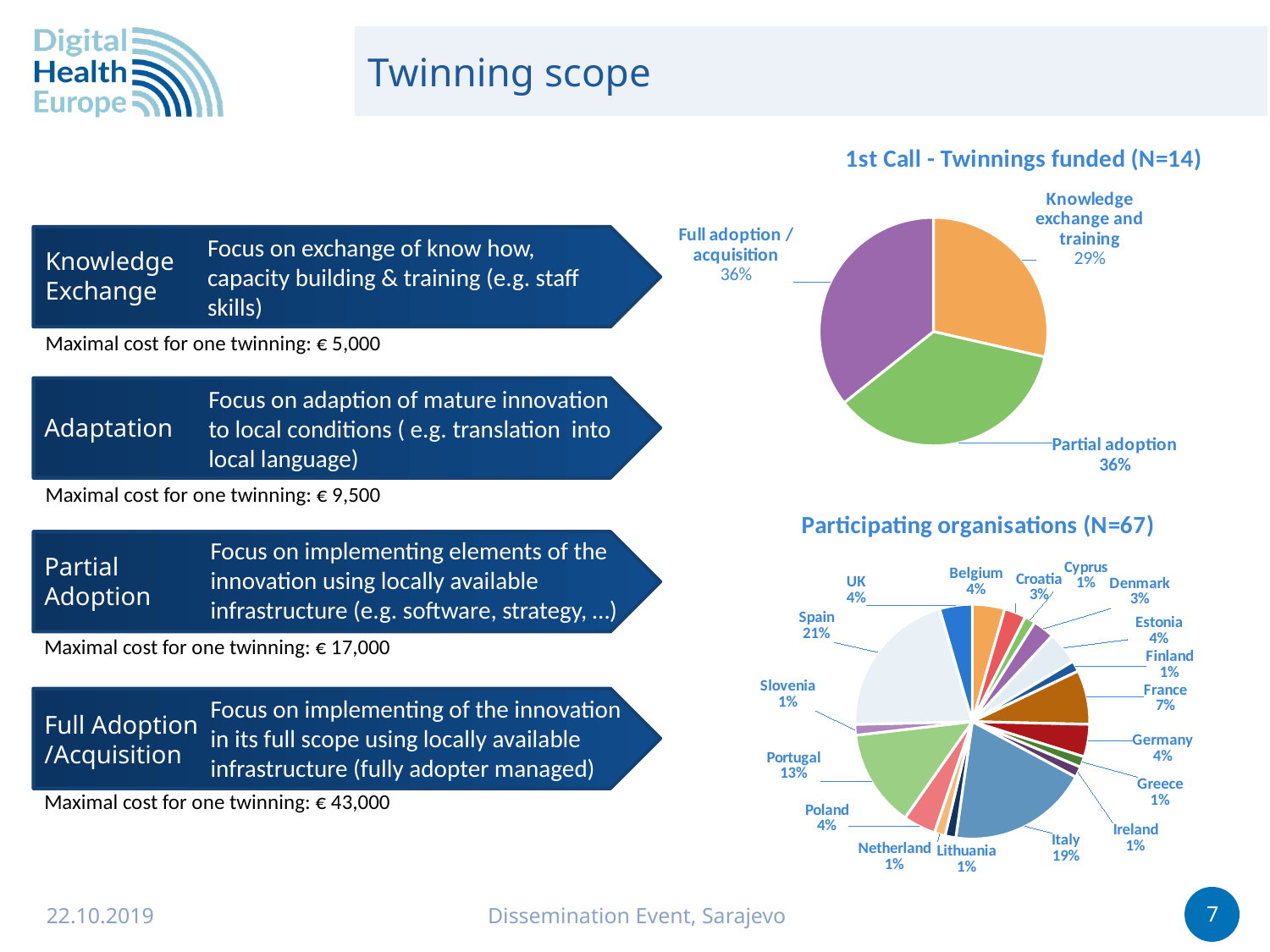
In the 'Participating organisations (N=67)' chart, what share is Portugal? 13% In the '1st Call - Twinnings funded (N=14)' chart, how many slices are there? 3 In the '1st Call - Twinnings funded (N=14)' chart, what is the difference between the Full adoption / acquisition share and the Knowledge exchange and training share? 7% In the 'Participating organisations (N=67)' chart, how many countries are shown? 18 In the '1st Call - Twinnings funded (N=14)' chart, which category has the smallest share? Knowledge exchange and training In the 'Participating organisations (N=67)' chart, which country has the largest share? Spain What kind of chart is the '1st Call - Twinnings funded (N=14)' chart? pie chart In the '1st Call - Twinnings funded (N=14)' chart, what share is Partial adoption? 36% In the 'Participating organisations (N=67)' chart, what share is Spain? 21% In the 'Participating organisations (N=67)' chart, what is the difference between the shares of Spain and Italy? 2% In the 'Participating organisations (N=67)' chart, which is larger, Italy or France? Italy